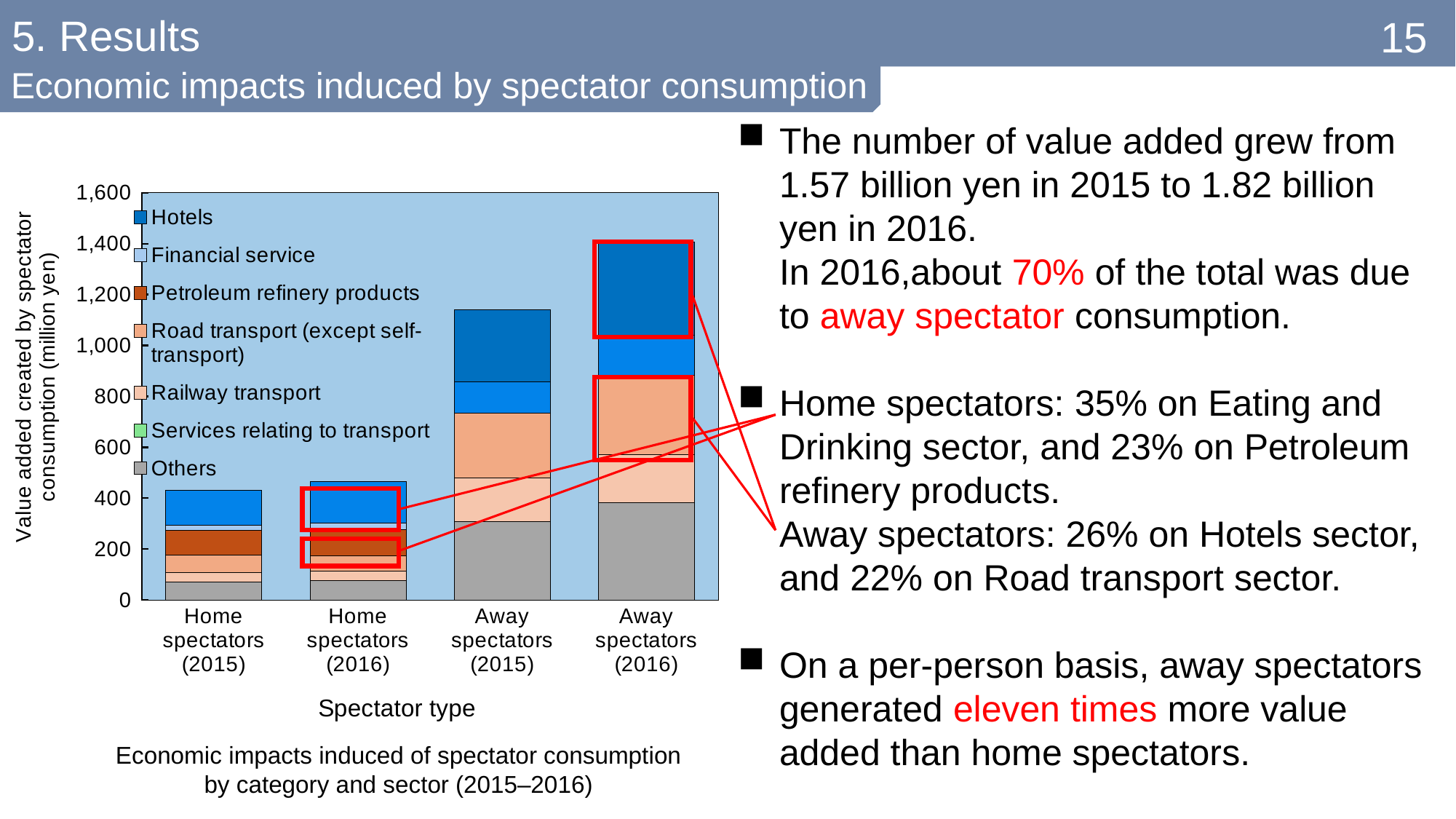
What kind of chart is shown on the slide? Stacked bar chart Is the total value added for Away spectators (2015) greater or less than 1,000? greater What is the label of the x axis? Spectator type How many series does the legend list? 7 How many spectator type categories are shown on the x axis? 4 Is the total value added for Home spectators (2015) greater or less than 600? less Which has a larger total value added: Home spectators (2016) or Away spectators (2015)? Away spectators (2015) Is the total value added for Home spectators (2016) greater or less than 600? less Do the total bar heights generally rise or fall moving from left to right along the x axis? Rise Which spectator type has the highest total value added? Away spectators (2016) What is the label of the y axis? Value added created by spectator consumption (million yen)